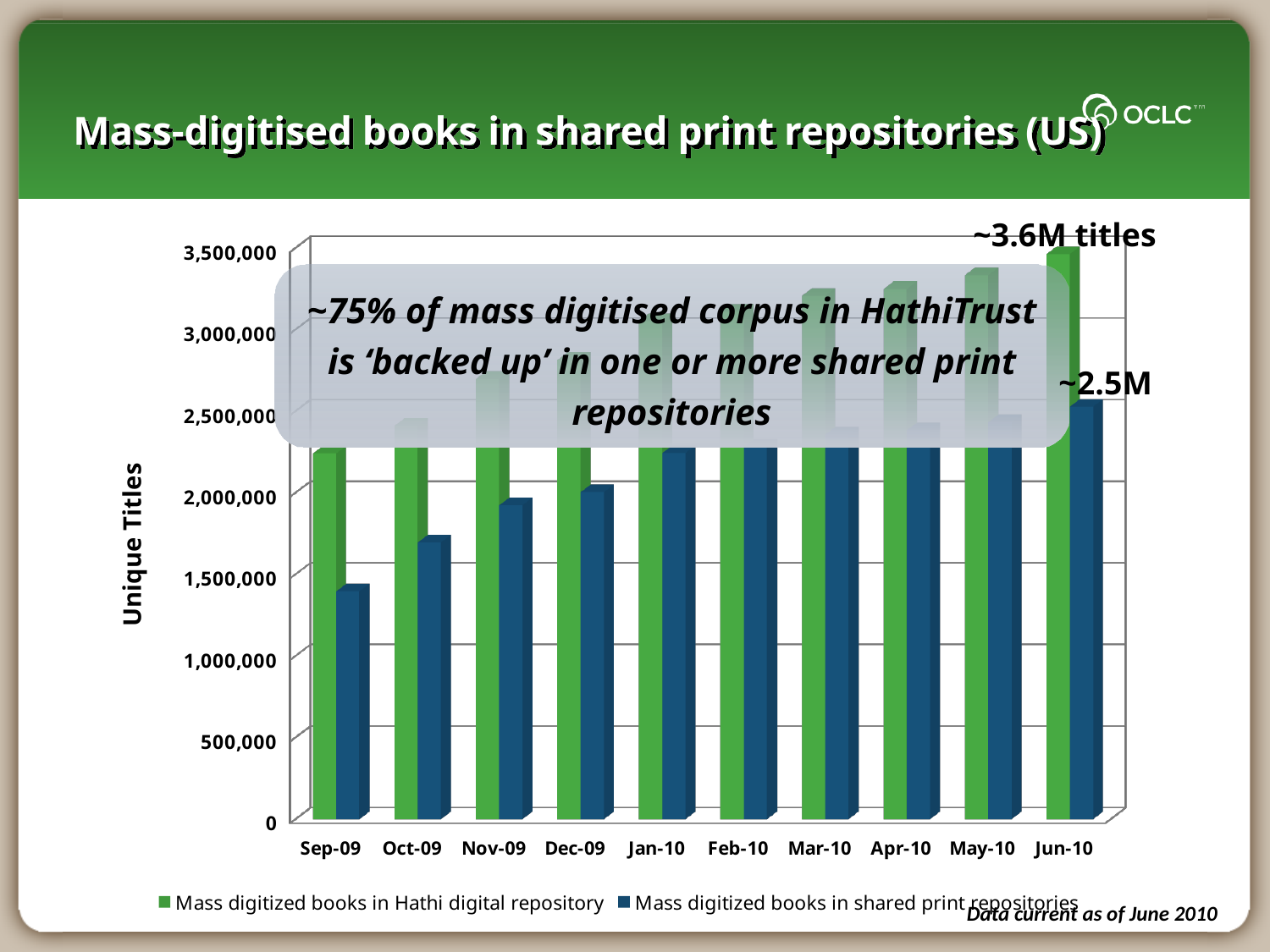
Is the value for mass digitized books in shared print repositories in Jan-10 greater or less than 2,000,000? greater Is the value for mass digitized books in shared print repositories in Sep-09 greater or less than 1,500,000? less How many months are shown along the x axis of the chart? 10 What is the label on the chart's y axis? Unique Titles What kind of chart is shown on the slide? bar chart In which month is the value for mass digitized books in shared print repositories highest? Jun-10 In Sep-09, which is larger: mass digitized books in Hathi digital repository or mass digitized books in shared print repositories? Mass digitized books in Hathi digital repository Is the value for mass digitized books in Hathi digital repository in Sep-09 greater or less than 2,000,000? greater How many series does the chart's legend list? 2 Do the values for mass digitized books in shared print repositories rise or fall from Sep-09 to Jun-10? rise In which month is the value for mass digitized books in Hathi digital repository lowest? Sep-09